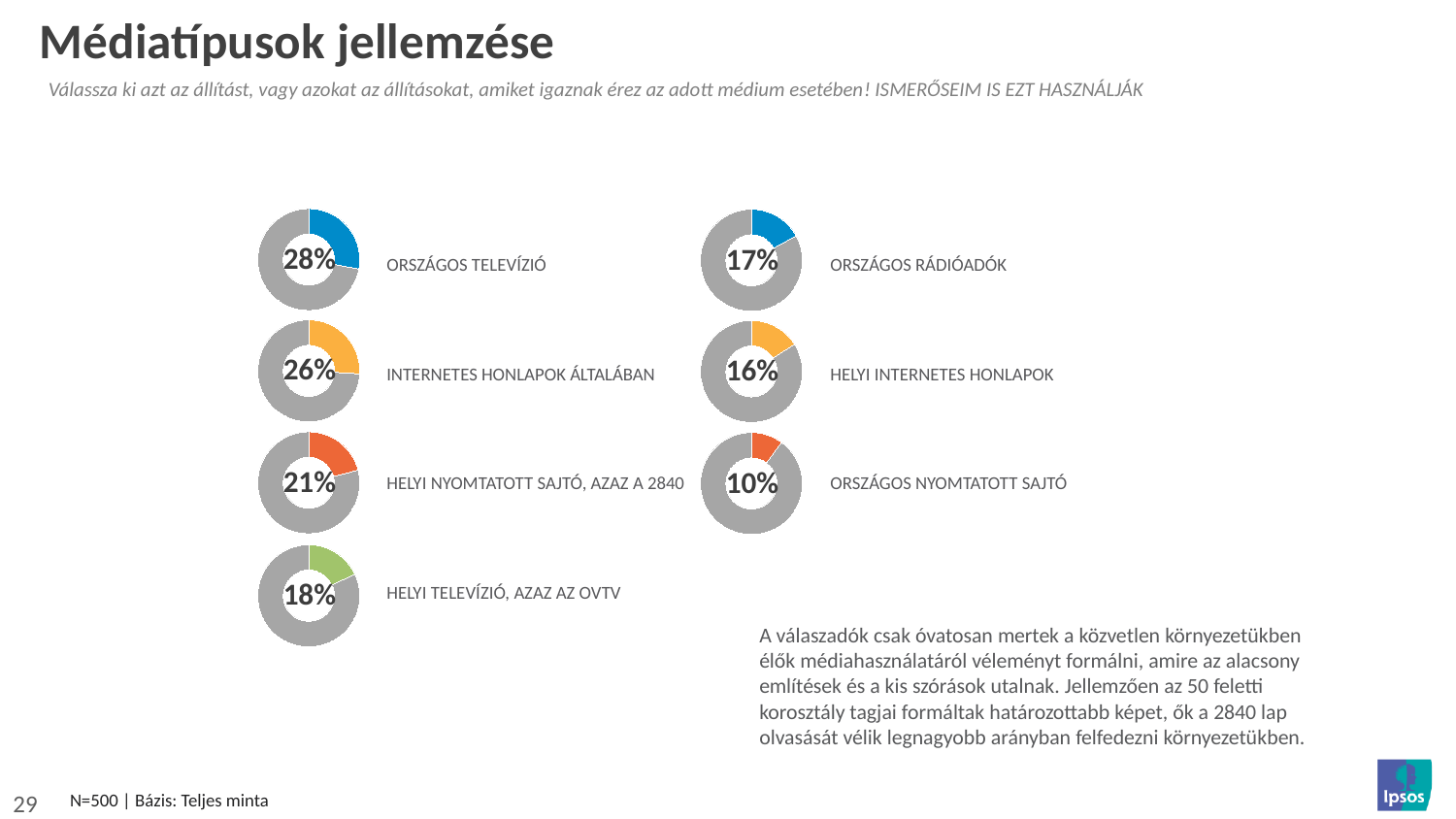
What kind of chart is used for ORSZÁGOS TELEVÍZIÓ on the slide? Donut chart What is the difference between the percentage in the ORSZÁGOS TELEVÍZIÓ chart and the percentage in the ORSZÁGOS NYOMTATOTT SAJTÓ chart? 18% In the donut chart labelled HELYI INTERNETES HONLAPOK, what percentage is shown? 16% In the donut chart labelled HELYI TELEVÍZIÓ, AZAZ AZ OVTV, what percentage is shown? 18% Which is larger: the percentage in the INTERNETES HONLAPOK ÁLTALÁBAN chart or the percentage in the HELYI NYOMTATOTT SAJTÓ, AZAZ A 2840 chart? INTERNETES HONLAPOK ÁLTALÁBAN Across all the donut charts on the slide, which media type has the highest percentage? ORSZÁGOS TELEVÍZIÓ Across all the donut charts on the slide, which media type has the lowest percentage? ORSZÁGOS NYOMTATOTT SAJTÓ In the donut chart labelled ORSZÁGOS RÁDIÓADÓK, what percentage is shown? 17% How many donut charts are shown on the slide? 7 In the donut chart labelled ORSZÁGOS NYOMTATOTT SAJTÓ, what percentage is shown? 10% In the donut chart labelled ORSZÁGOS TELEVÍZIÓ, what percentage is shown? 28% In the donut chart labelled HELYI NYOMTATOTT SAJTÓ, AZAZ A 2840, what colour is the highlighted segment? Orange-red